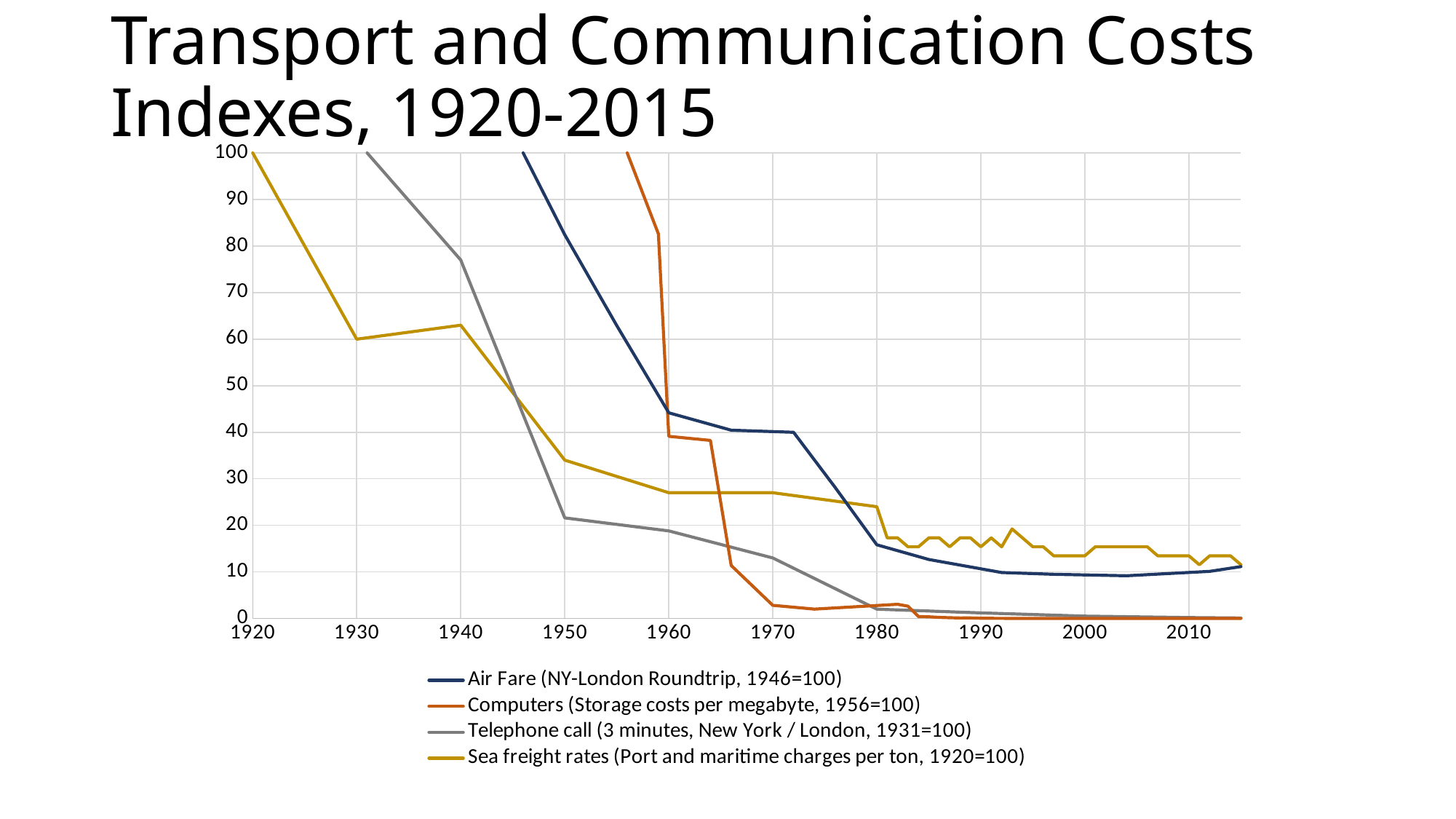
What is the value of the Sea freight rates index in 1920? 100 What kind of chart is shown on the slide? line chart Is the value of the Air Fare index in 1960 greater or less than 40? greater Is the value of the Sea freight rates index in 1950 greater or less than 30? greater Which series has the highest value in 2010? Sea freight rates Is the value of the Computers index in 1970 greater or less than 10? less What is the value of the Air Fare index in 1946? 100 In 1980, which is larger: the Sea freight rates index or the Air Fare index? Sea freight rates How many series does the legend list? 4 What is the title of the chart? Transport and Communication Costs Indexes, 1920-2015 What is the value of the Computers index in 1956? 100 Do the index values generally rise or fall from 1920 to 2015? fall